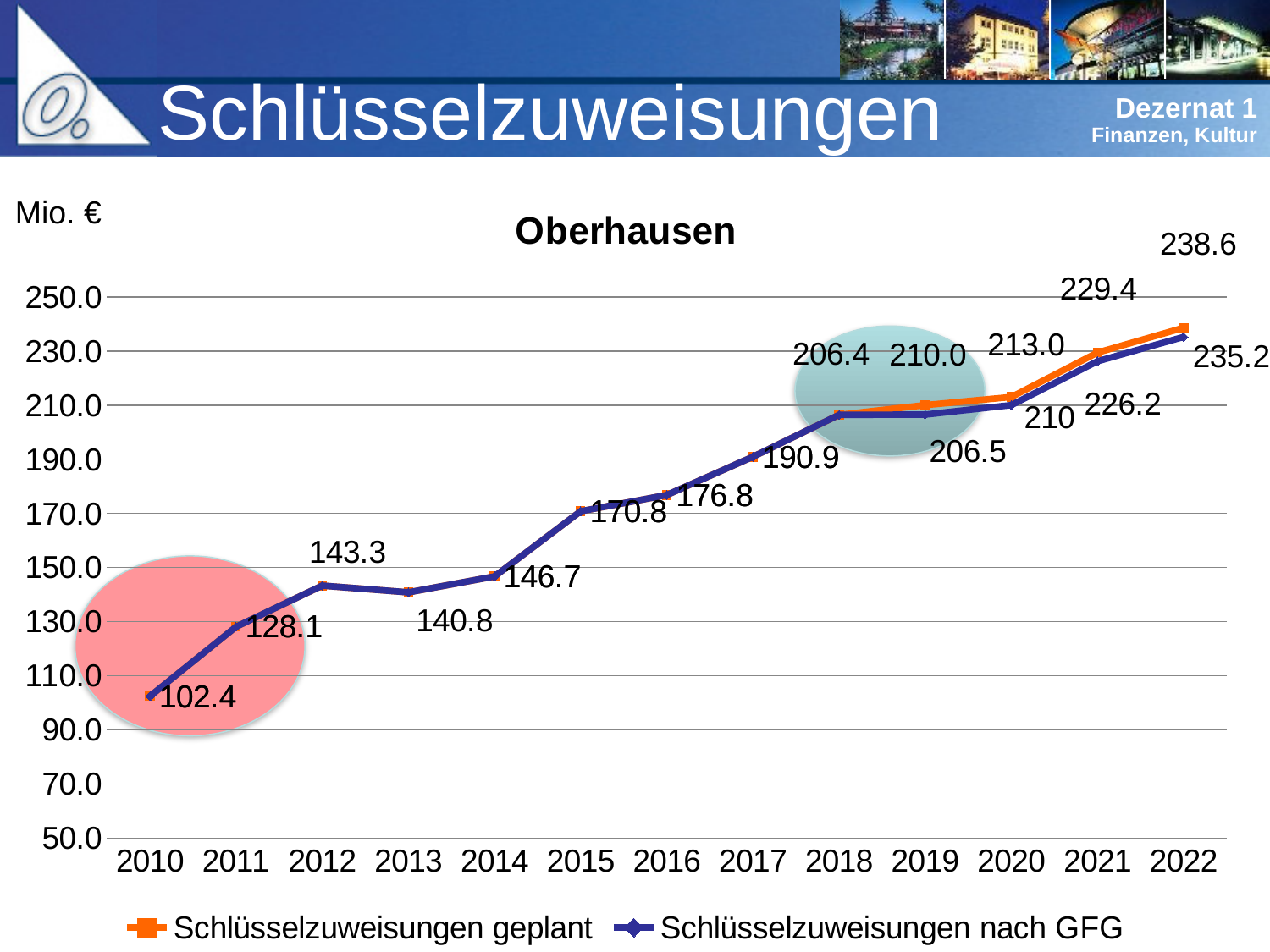
What is the value of 'Schlüsselzuweisungen nach GFG' for 2021? 226.2 What is the value of 'Schlüsselzuweisungen geplant' for 2022? 238.6 What is the value for 2010? 102.4 What kind of chart is shown on the slide? line chart Which year has the highest value for 'Schlüsselzuweisungen geplant'? 2022 What is the title of the chart? Oberhausen What is the value for 2015? 170.8 Which year has the lowest value? 2010 How many series does the legend list? 2 What is the difference between the values for 2012 and 2013? 2.5 How many years are shown on the x axis? 13 Which is larger, the value for 2016 or the value for 2017? 2017